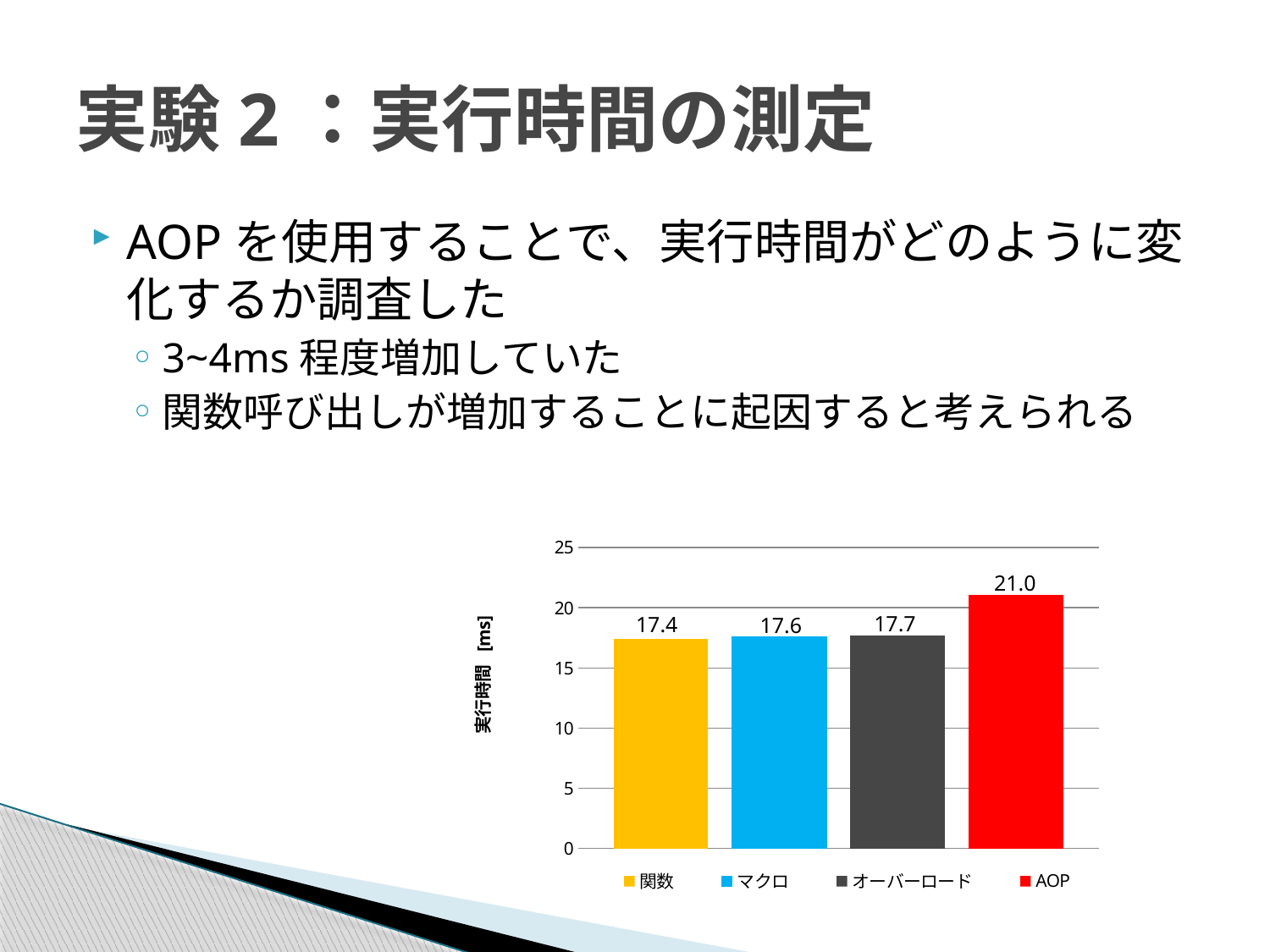
What is the execution time shown for マクロ? 17.6 What kind of chart is shown on the slide? bar chart Which is larger, the value for AOP or the value for オーバーロード? AOP How many bars are plotted in the chart? 4 What is the execution time shown for オーバーロード? 17.7 Which bar has the lowest execution time? 関数 Which bar has the highest execution time? AOP Is the value for AOP greater or less than 20? greater What is the execution time shown for AOP? 21.0 What is the difference between the AOP value and the 関数 value? 3.6 How many entries does the legend list? 4 What is the execution time shown for 関数? 17.4